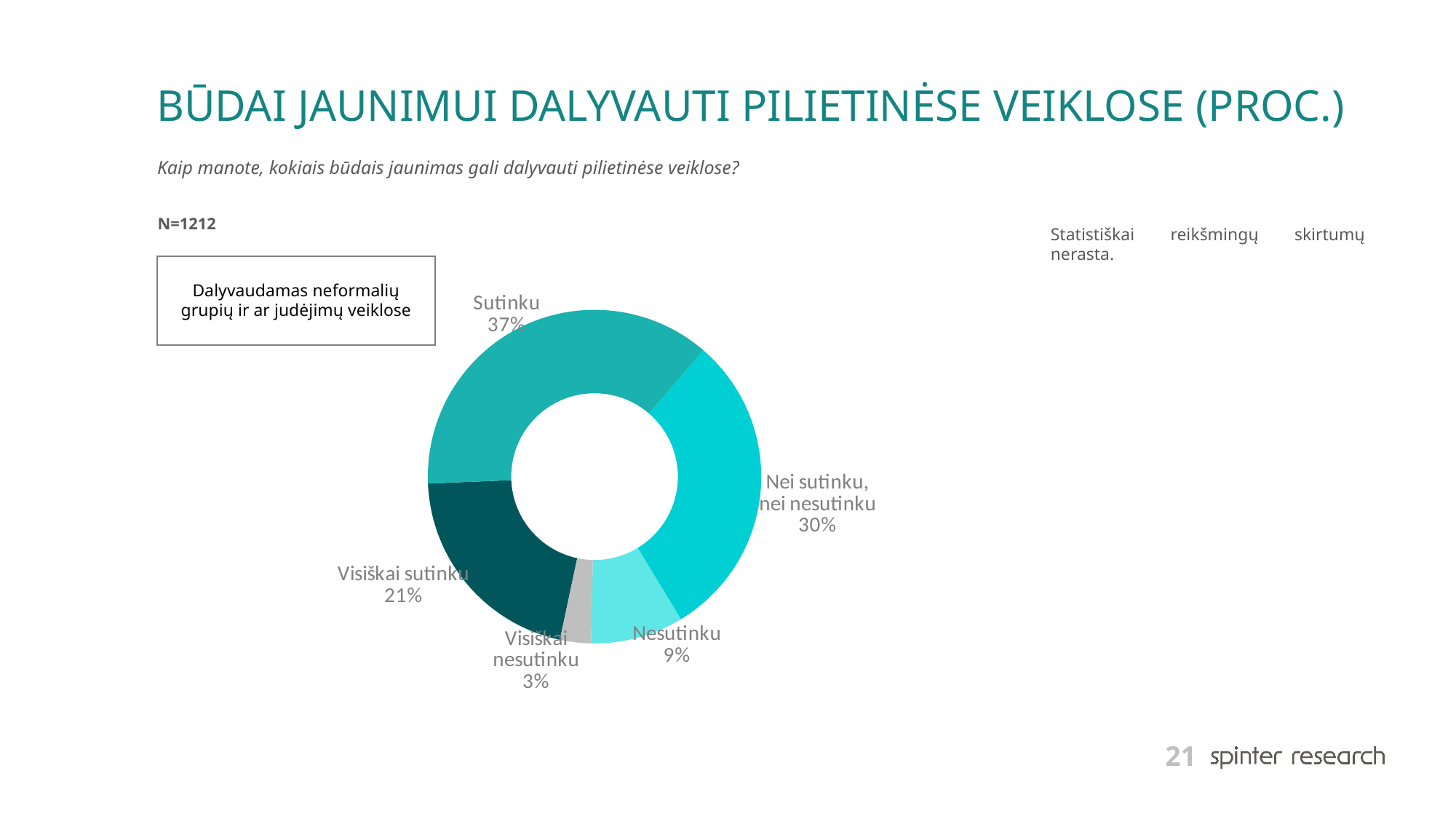
What is the sample size (N) stated on the slide? N=1212 What type of chart is shown on the slide? Doughnut chart What percentage of respondents answered "Nei sutinku, nei nesutinku"? 30% Which response category has the smallest share? Visiškai nesutinku What percentage of respondents answered "Nesutinku"? 9% What is the difference in percentage points between "Sutinku" and "Visiškai sutinku"? 16 What percentage of respondents answered "Visiškai sutinku"? 21% Which is larger, the share for "Nei sutinku, nei nesutinku" or the share for "Visiškai sutinku"? Nei sutinku, nei nesutinku What percentage of respondents answered "Visiškai nesutinku"? 3% What percentage of respondents answered "Sutinku"? 37% How many response categories are shown in the chart? 5 Which response category has the largest share? Sutinku